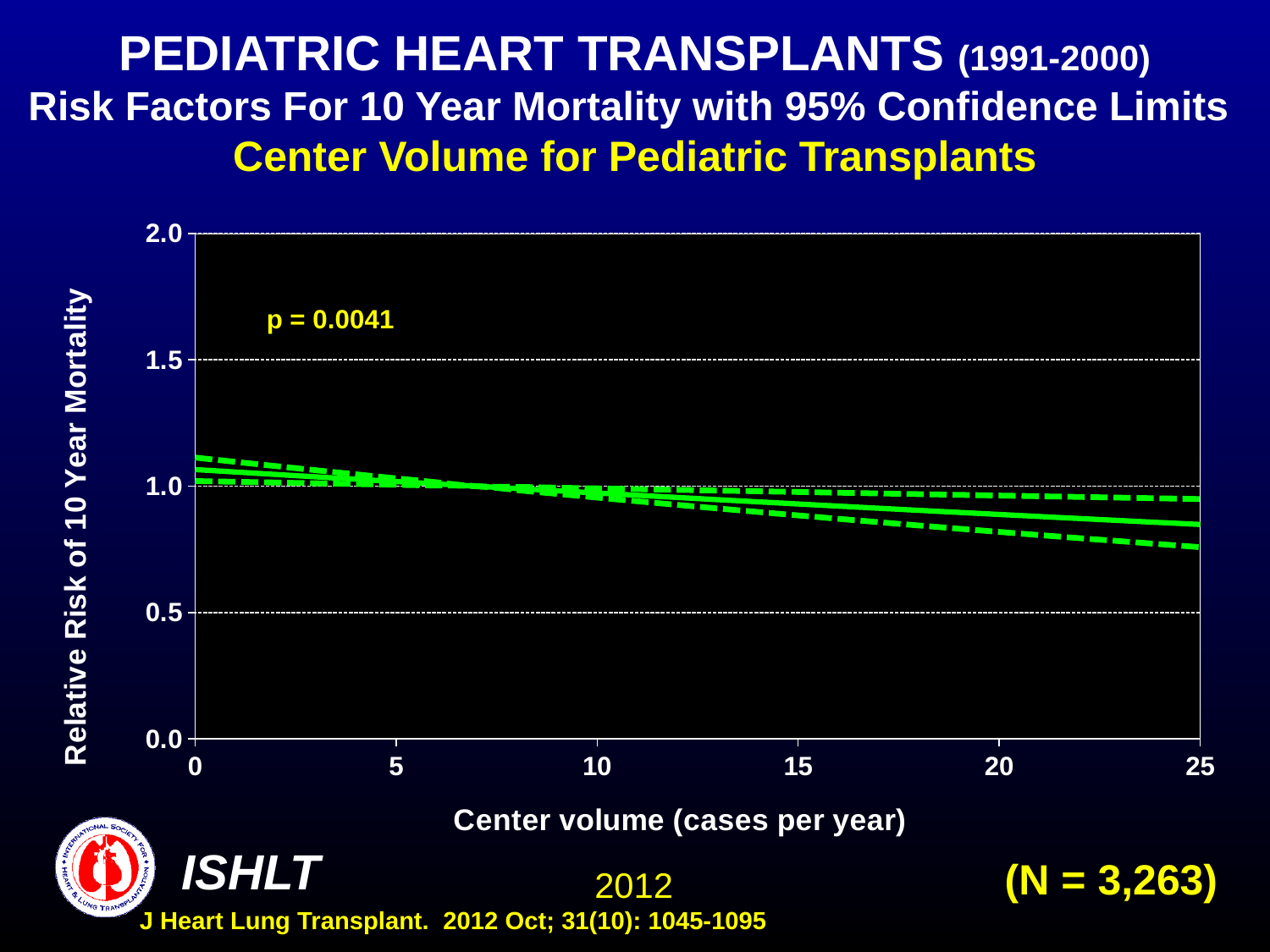
What is the label of the x axis? Center volume (cases per year) Is the lower dashed confidence limit at a center volume of 25 greater or less than 1.0? less Does the relative risk of 10 year mortality rise or fall as center volume increases along the x axis? fall How many lines are plotted on the chart? 3 What kind of chart is shown on the slide? line chart Is the upper dashed confidence limit at a center volume of 0 greater or less than 1.0? greater What is the highest center volume value shown on the x axis? 25 What is the highest value shown on the y axis? 2.0 What p-value is printed on the chart? p = 0.0041 Is the relative risk shown by the solid line at a center volume of 10 greater or less than 1.5? less